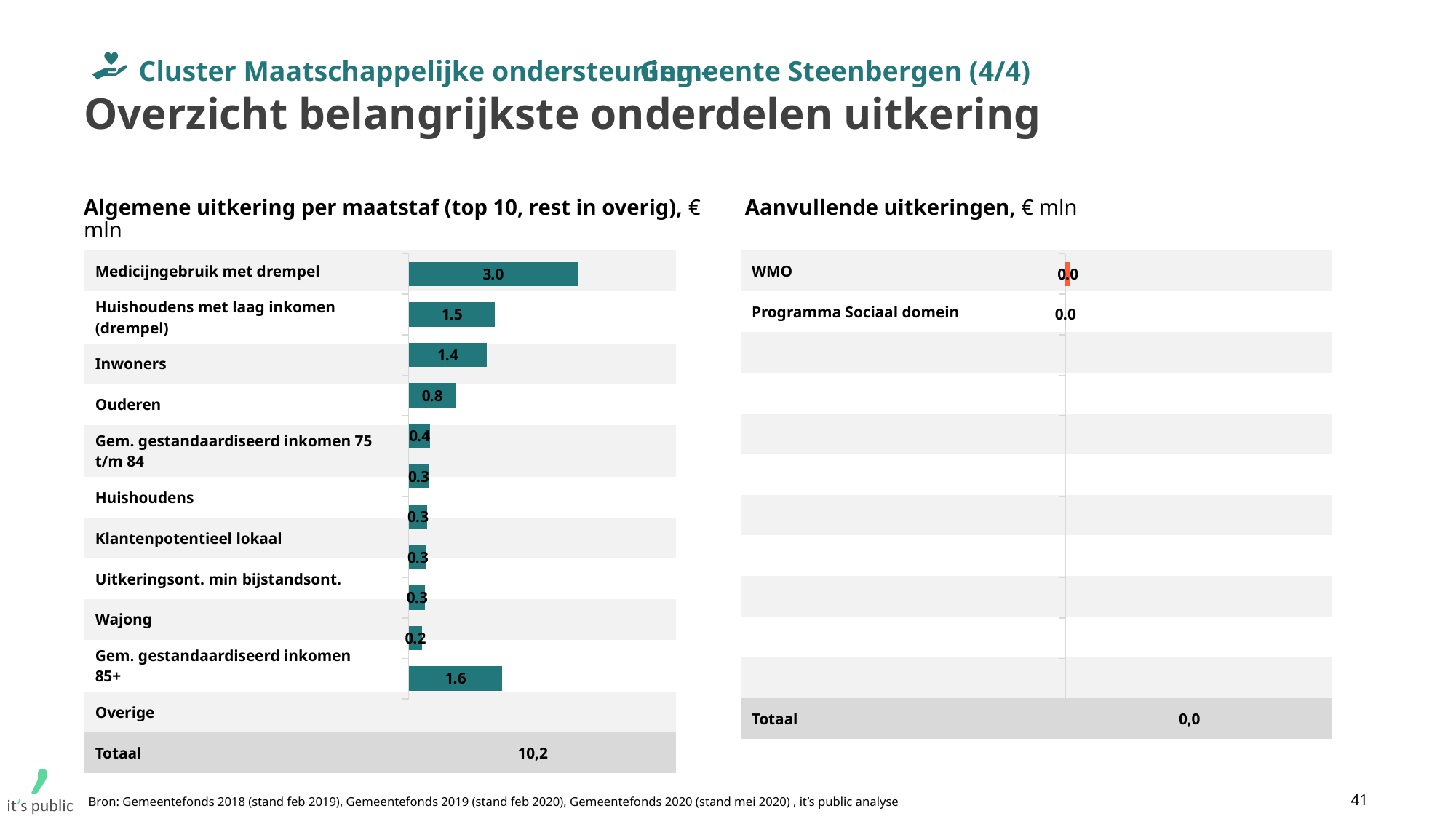
In the chart 'Algemene uitkering per maatstaf', what is the value for Inwoners? 1.4 In the chart 'Algemene uitkering per maatstaf', what is the value for Medicijngebruik met drempel? 3.0 What kind of chart is 'Algemene uitkering per maatstaf'? Bar chart In the chart 'Algemene uitkering per maatstaf', which maatstaf has the highest value? Medicijngebruik met drempel In the chart 'Algemene uitkering per maatstaf', what is the Totaal shown? 10,2 In the chart 'Algemene uitkering per maatstaf', which named maatstaf has the lowest value? Gem. gestandaardiseerd inkomen 85+ In the chart 'Aanvullende uitkeringen', what is the value for WMO? 0.0 In the chart 'Algemene uitkering per maatstaf', what is the difference between Medicijngebruik met drempel and Huishoudens met laag inkomen (drempel)? 1.5 In the chart 'Algemene uitkering per maatstaf', which is larger: Ouderen or Inwoners? Inwoners How many categories are listed in the chart 'Aanvullende uitkeringen' (excluding Totaal)? 2 In what unit are the values in the chart 'Aanvullende uitkeringen' expressed? € mln In the chart 'Algemene uitkering per maatstaf', what is the value for Overige? 1.6